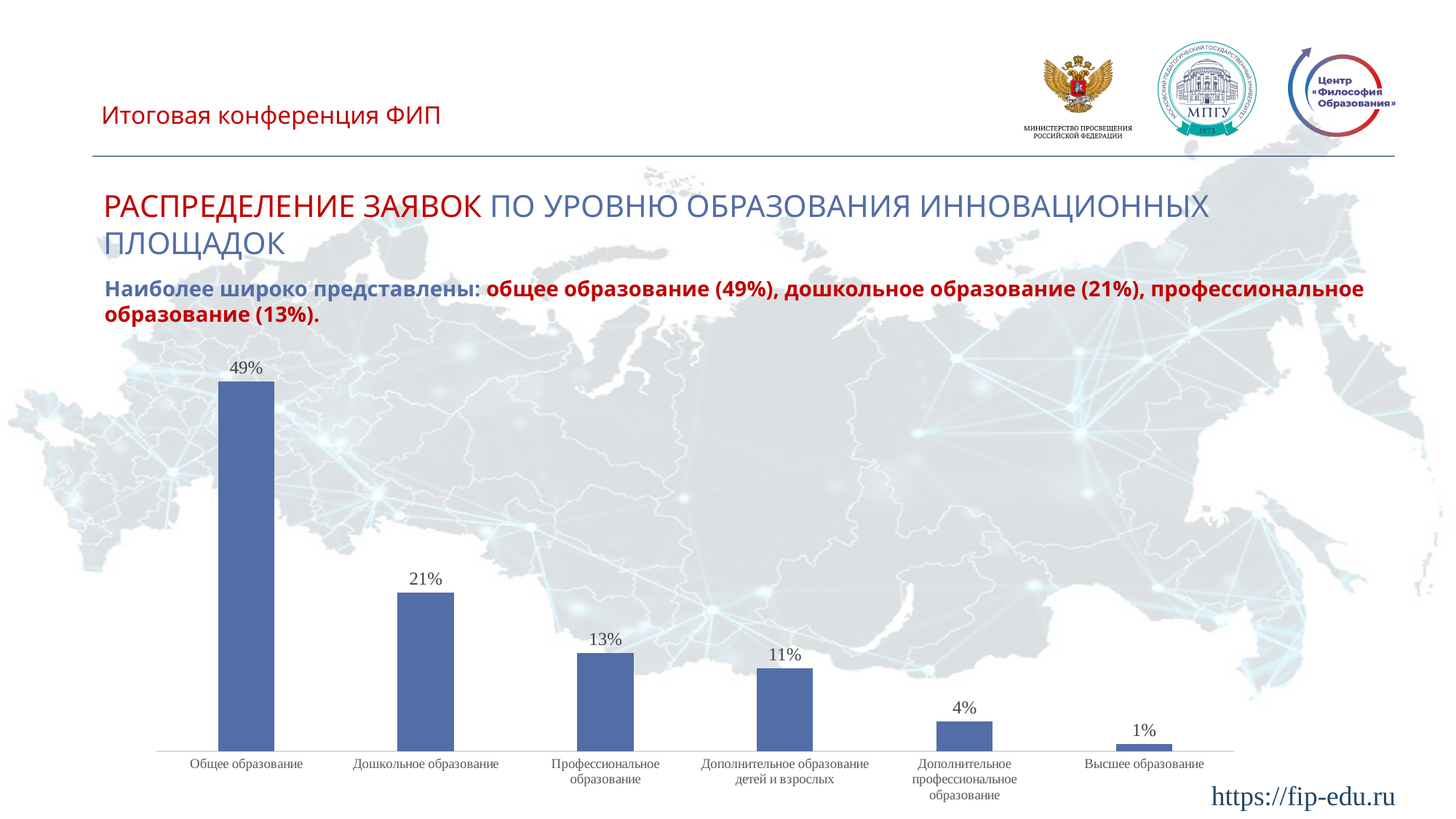
What is the value for Дошкольное образование? 21% Which category has the highest value? Общее образование What is the value for Высшее образование? 1% How many categories are shown in the chart? 6 What kind of chart is shown on the slide? Bar chart What is the value for Профессиональное образование? 13% Do the values rise or fall from left to right along the x axis? Fall What is the value for Дополнительное образование детей и взрослых? 11% Which category has the lowest value? Высшее образование Which is larger, the value for Профессиональное образование or Дополнительное образование детей и взрослых? Профессиональное образование What is the value for Общее образование? 49% What is the difference between the values for Общее образование and Дошкольное образование? 28%